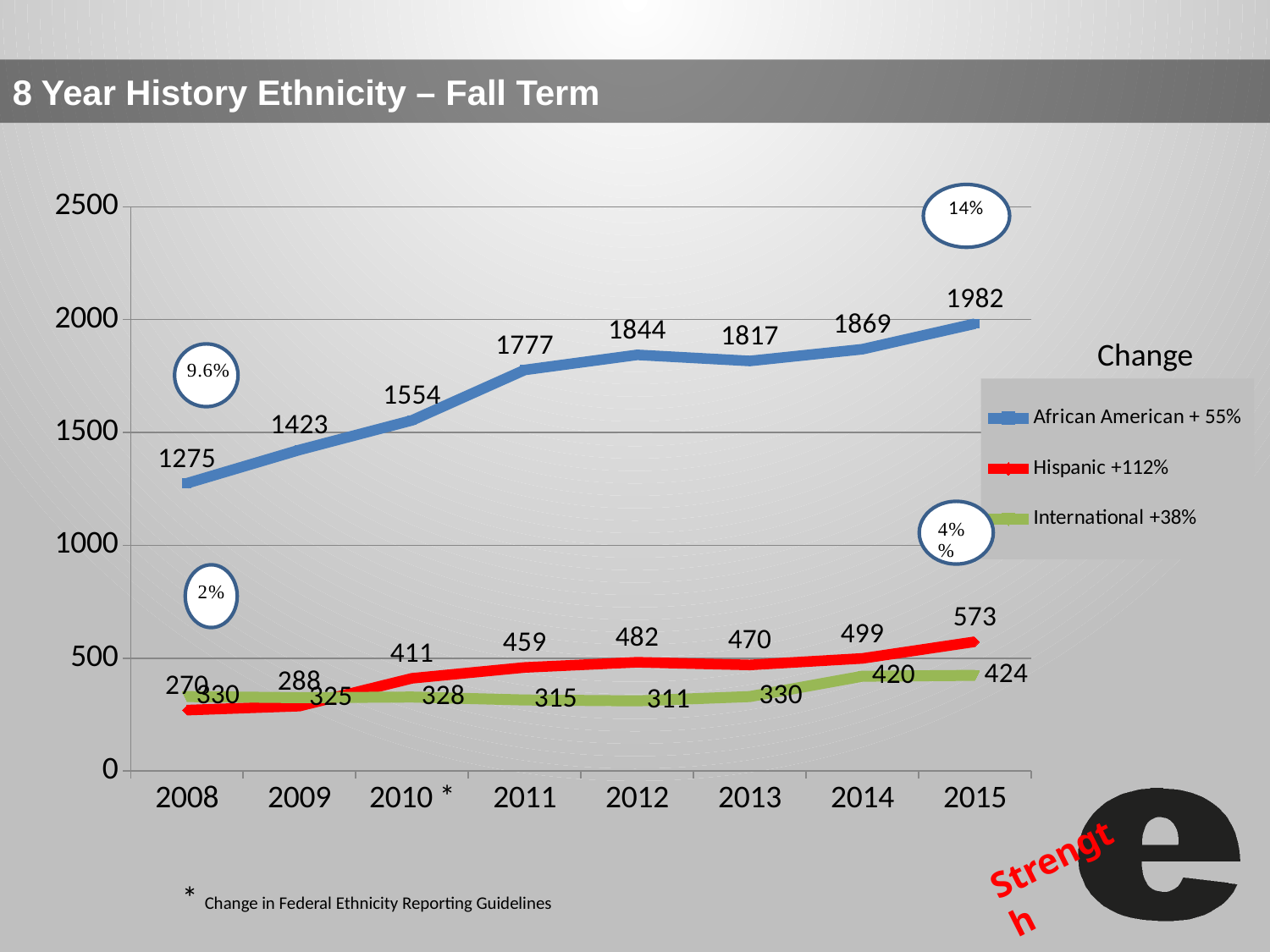
What kind of chart is shown on the slide? line chart What is the difference between the African American values for 2015 and 2008? 707 Which is larger in 2008, the Hispanic value or the International value? International In which year is the African American series highest? 2015 How many series does the legend list? 3 What percentage change does the legend give for the Hispanic series? +112% In which year is the Hispanic series lowest? 2008 Does the African American series generally rise or fall from 2008 to 2015? rise What is the African American value for 2015? 1982 What is the International value for 2012? 311 What is the Hispanic value for 2010? 411 How many years are shown on the x axis? 8